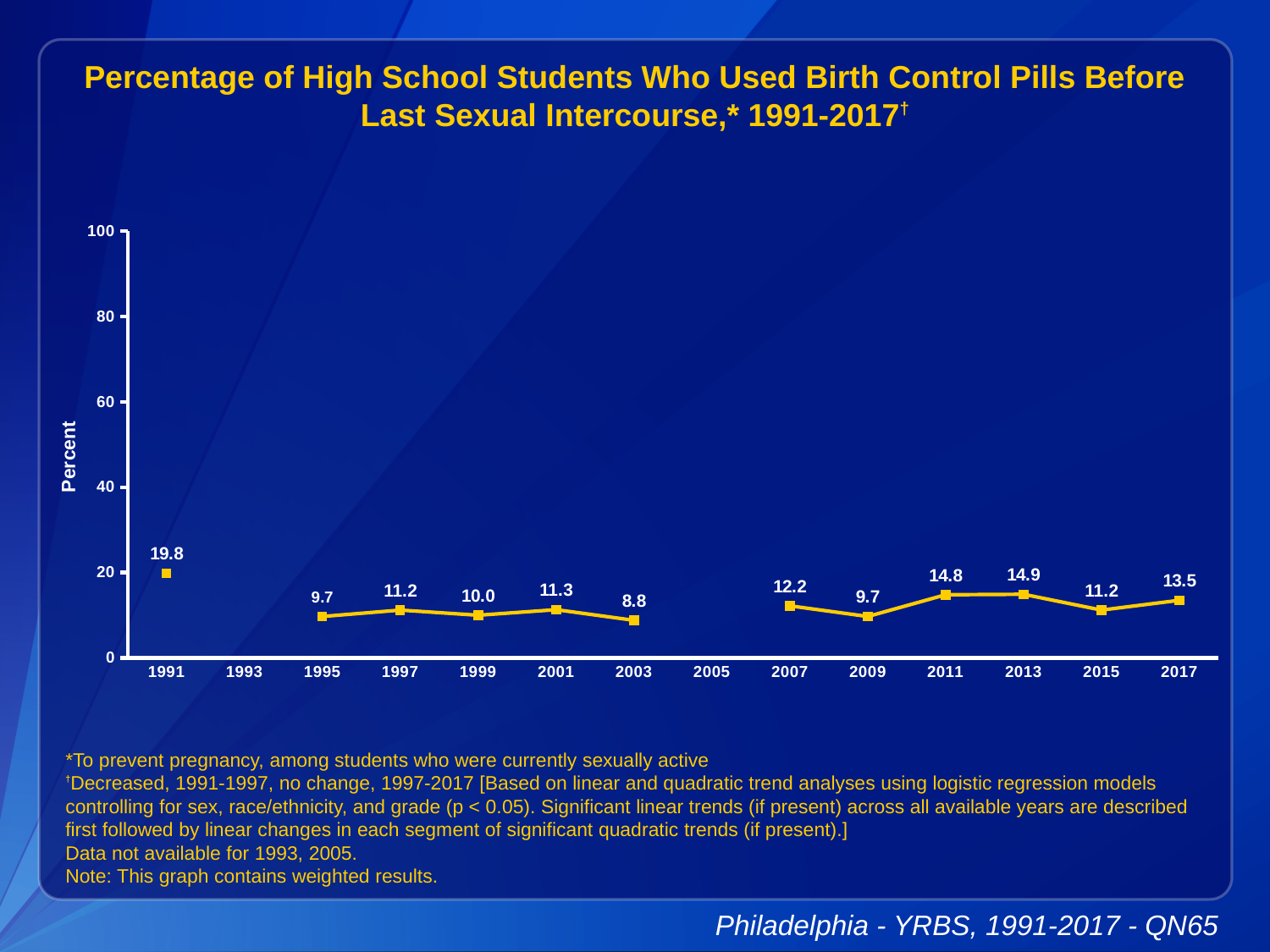
What kind of chart is shown on the slide? line chart What was the percentage of high school students who used birth control pills before last sexual intercourse in 1991? 19.8 What value is shown for 2003? 8.8 How many years have data points plotted on the chart? 12 Which year has the larger value, 2011 or 2015? 2011 Which year has the highest value on the chart? 1991 What is the label on the y axis? Percent What value is shown for 2017? 13.5 What is the difference between the values for 1991 and 2017? 6.3 Did the value rise or fall from 1991 to 1997? fall Is the value for 2013 greater or less than 20? less Which year has the lowest value on the chart? 2003